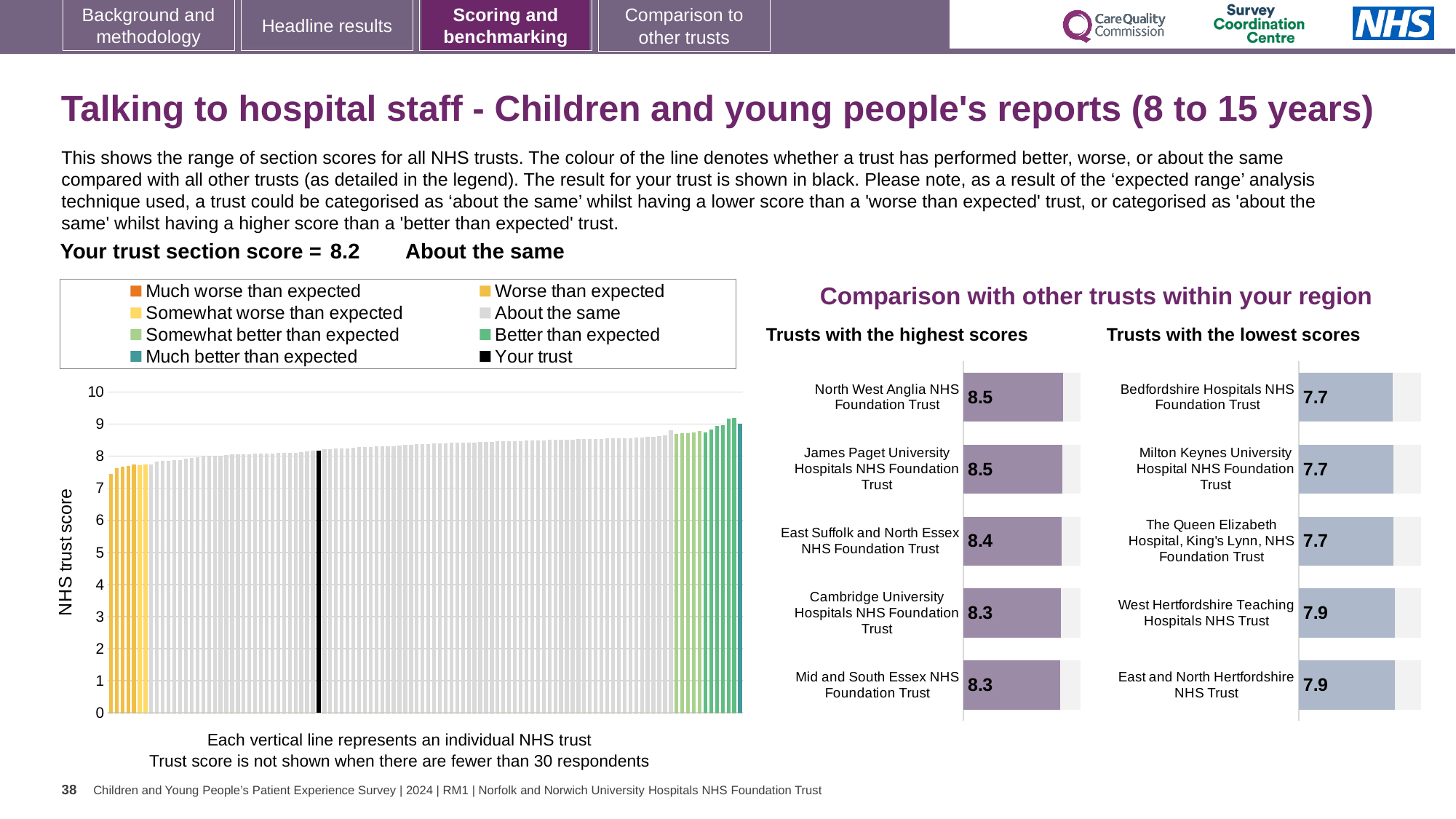
In the large chart on the left, do the NHS trust scores rise or fall from left to right along the x axis? Rise In the 'Trusts with the lowest scores' chart, what is the score for West Hertfordshire Teaching Hospitals NHS Trust? 7.9 What kind of chart is the large chart on the left showing NHS trust scores? Bar chart In the 'Trusts with the highest scores' chart, which has the larger score: East Suffolk and North Essex NHS Foundation Trust or Cambridge University Hospitals NHS Foundation Trust? East Suffolk and North Essex NHS Foundation Trust In the large chart on the left, is the value of the lowest (leftmost) bar greater or less than 8? less In the 'Trusts with the highest scores' chart, what is the score for North West Anglia NHS Foundation Trust? 8.5 How many trusts are listed in the 'Trusts with the lowest scores' chart? 5 How many entries does the legend above the large chart on the left list? 8 In the 'Trusts with the highest scores' chart, what is the score for East Suffolk and North Essex NHS Foundation Trust? 8.4 In the 'Trusts with the lowest scores' chart, what is the score for Bedfordshire Hospitals NHS Foundation Trust? 7.7 In the 'Trusts with the lowest scores' chart, what is the difference between the scores of East and North Hertfordshire NHS Trust and Milton Keynes University Hospital NHS Foundation Trust? 0.2 In the 'Trusts with the highest scores' chart, what is the difference between the scores of North West Anglia NHS Foundation Trust and Mid and South Essex NHS Foundation Trust? 0.2